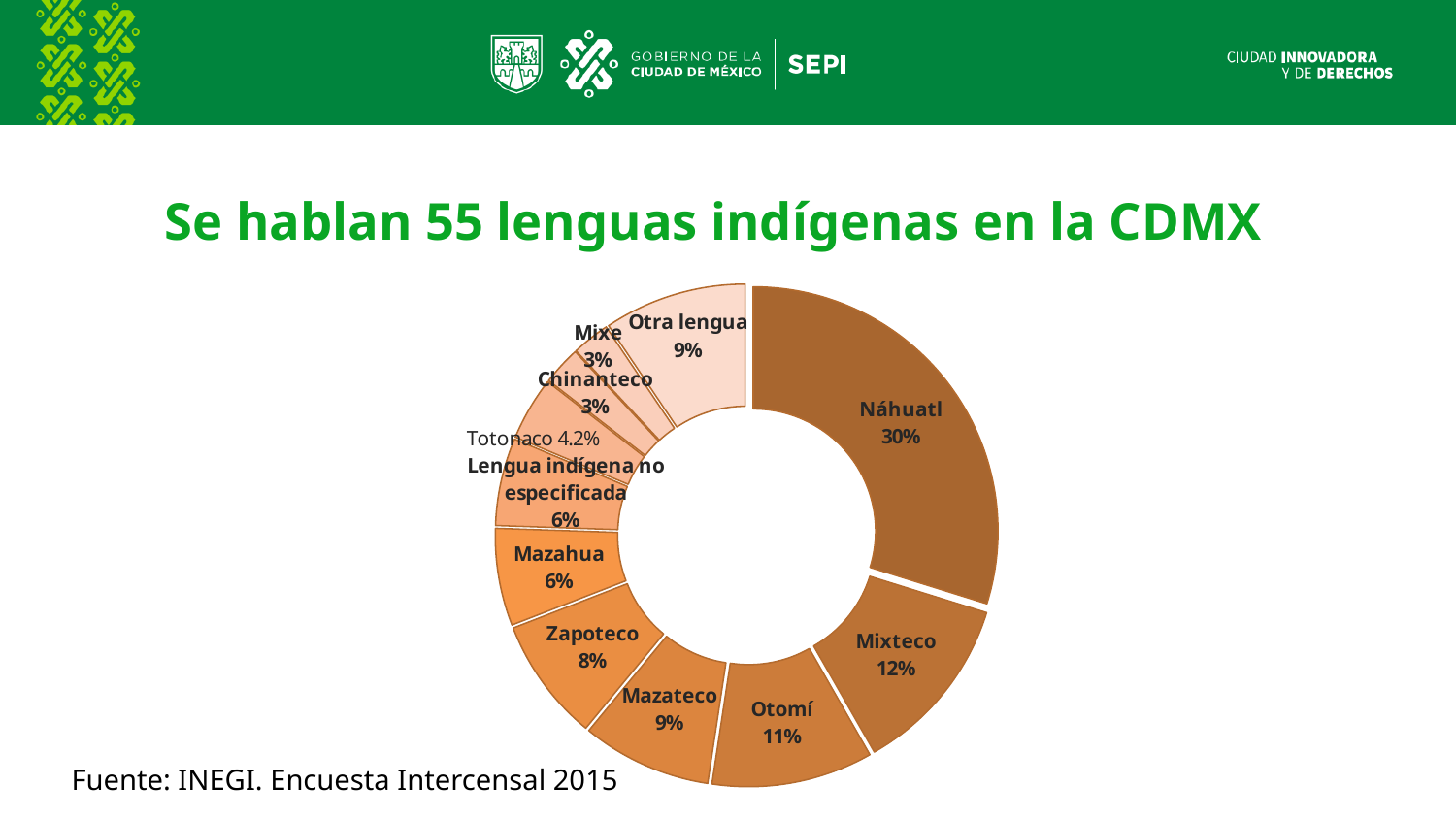
Which language has the largest slice in the chart? Náhuatl What source is cited below the chart? INEGI. Encuesta Intercensal 2015 How many slices does the chart have? 11 What is the difference in percentage points between Náhuatl and Mixteco? 18 What is the difference in percentage points between Mazateco and Mazahua? 3 What percentage does the Mixteco slice show? 12% Which slice is larger, Otomí or Zapoteco? Otomí What type of chart is shown on the slide? pie chart (donut) What percentage is shown for Totonaco? 4.2% What is the title of the slide above the chart? Se hablan 55 lenguas indígenas en la CDMX What percentage is shown for Lengua indígena no especificada? 6% What percentage does the Náhuatl slice show? 30%